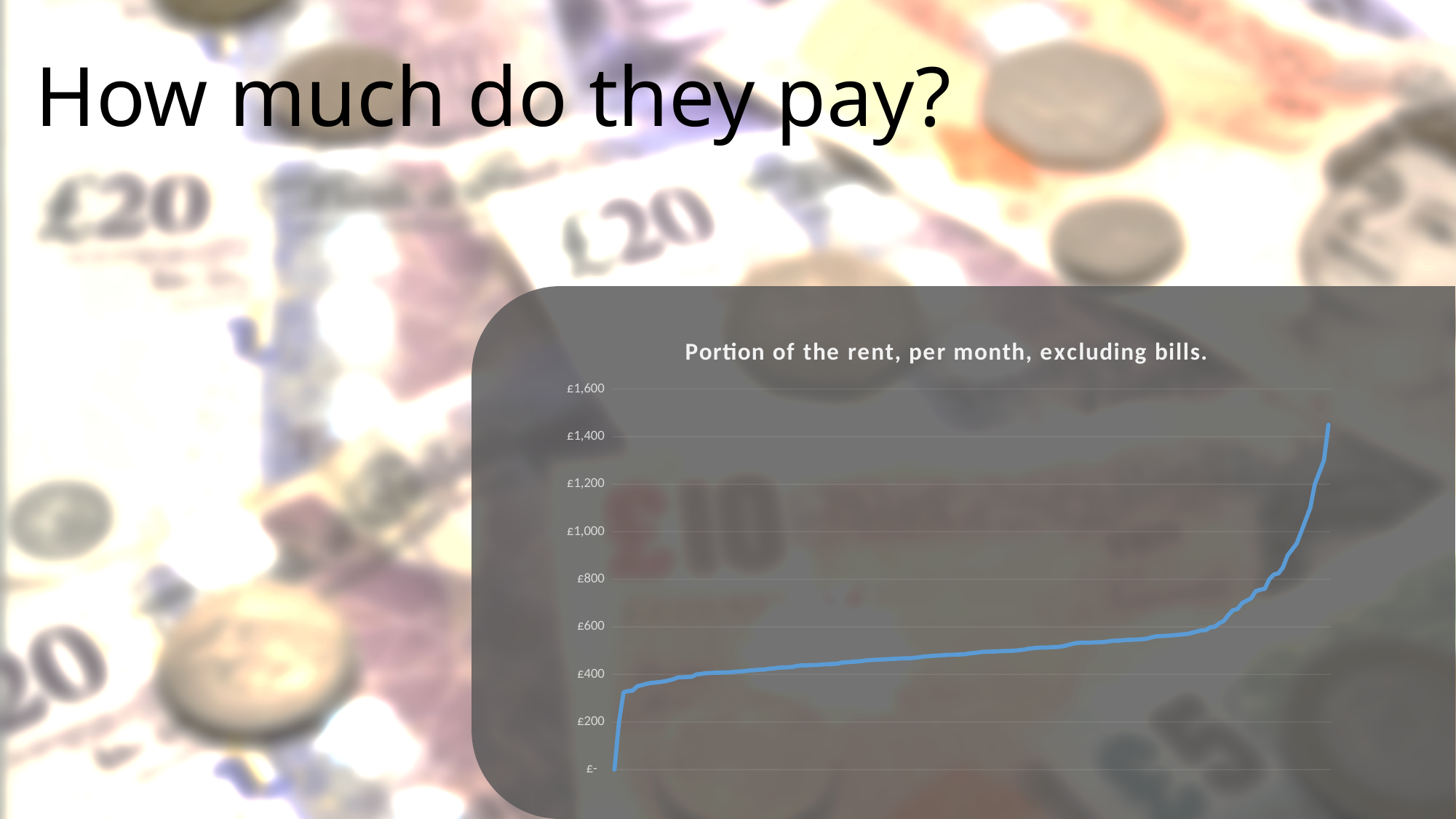
What is the title of the chart? Portion of the rent, per month, excluding bills. Is the highest value on the line greater or less than £1,200? greater Is the value at the midpoint of the line greater or less than £800? less What is the highest value shown on the vertical axis? £1,600 Do the values on the chart rise or fall from left to right along the x axis? rise What kind of chart is shown on the slide? line chart Is the lowest value on the line greater or less than £200? less